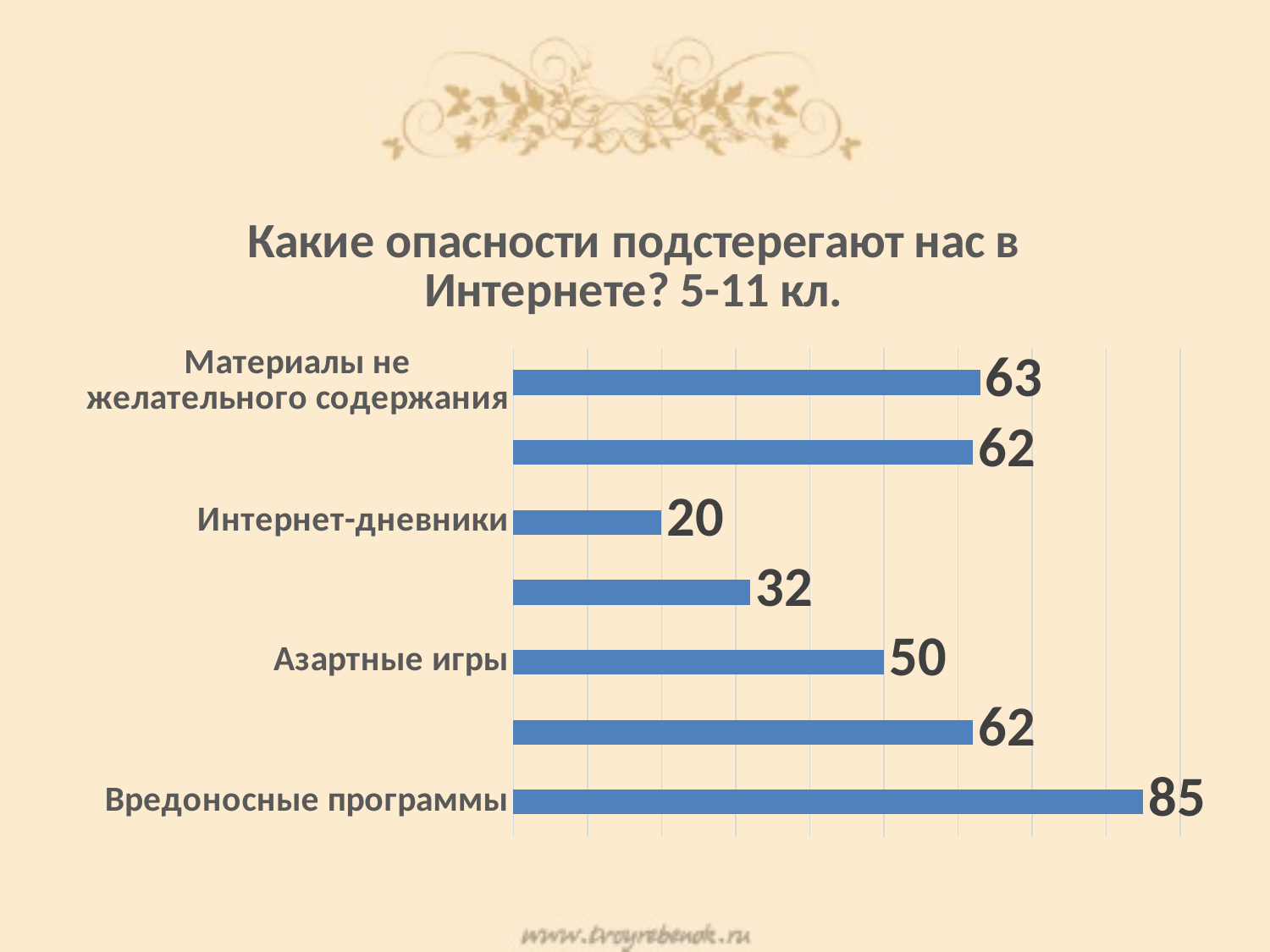
What is the value for Вредоносные программы? 85 What is the value for Интернет-дневники? 20 Which category has the highest value? Вредоносные программы What kind of chart is shown on the slide? bar chart How many bars are plotted in the chart? 7 What is the title of the chart? Какие опасности подстерегают нас в Интернете? 5-11 кл. Which is larger, the value for Азартные игры or the value for Интернет-дневники? Азартные игры What is the value for Материалы не желательного содержания? 63 What is the difference between the values for Вредоносные программы and Азартные игры? 35 What is the difference between the values for Материалы не желательного содержания and Интернет-дневники? 43 What is the value for Азартные игры? 50 Which category has the lowest value? Интернет-дневники